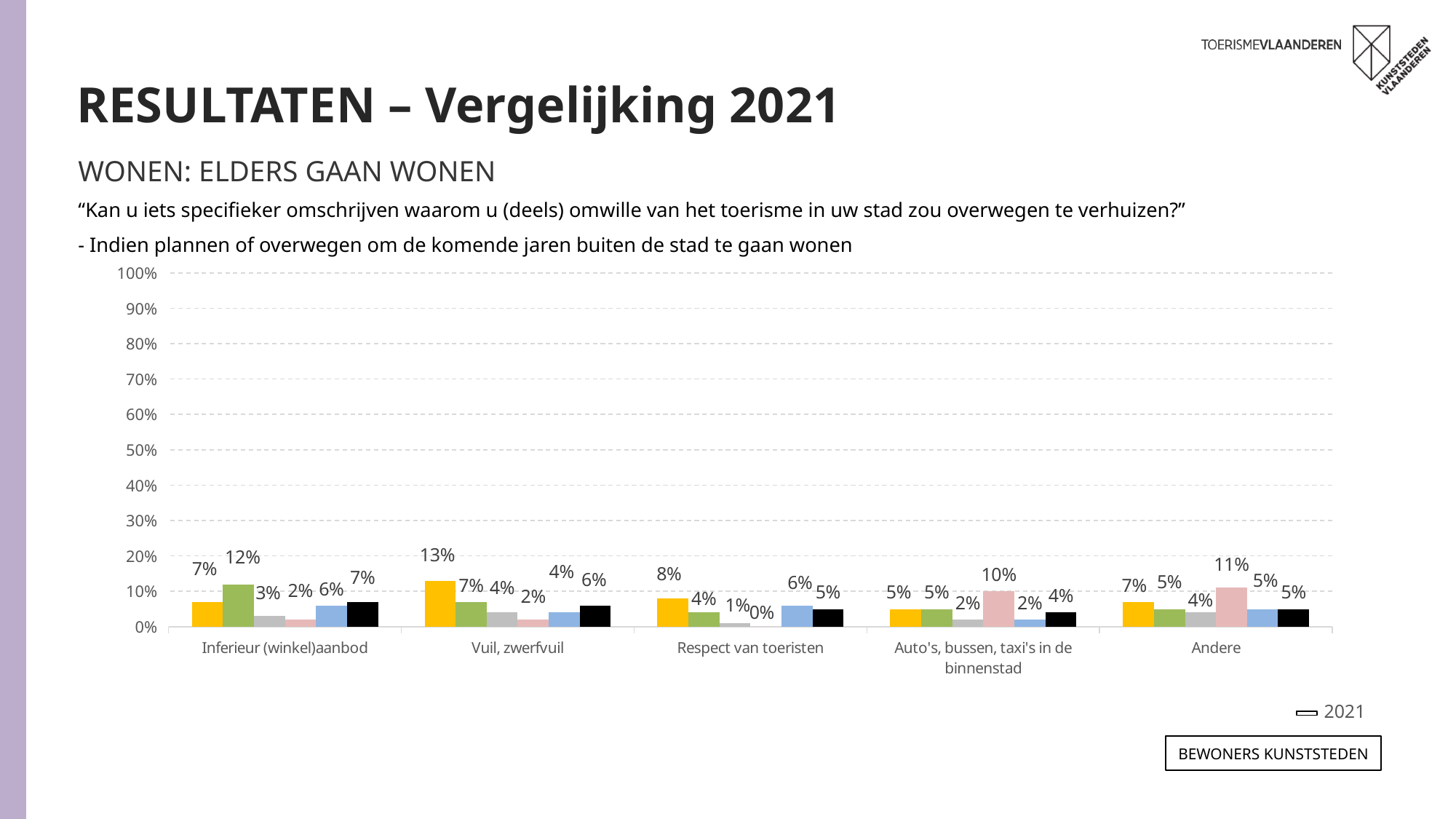
What is the highest value shown in the 'Andere' category? 11% What is the highest value shown in the 'Auto's, bussen, taxi's in de binnenstad' category? 10% What is the highest value labelled anywhere on the chart? 13% Which is larger: the tallest bar in 'Respect van toeristen' or the tallest bar in 'Auto's, bussen, taxi's in de binnenstad'? Auto's, bussen, taxi's in de binnenstad Which category contains the bar labelled 0%? Respect van toeristen Which category contains the tallest bar on the chart? Vuil, zwerfvuil What is the difference between the tallest bar in 'Vuil, zwerfvuil' and the tallest bar in 'Inferieur (winkel)aanbod'? 1% Is the tallest bar on the chart greater or less than 20%? less What is the lowest value labelled on the chart? 0% How many categories are shown along the x axis of the chart? 5 What kind of chart is shown on the slide? bar chart What entry does the legend below the chart show? 2021